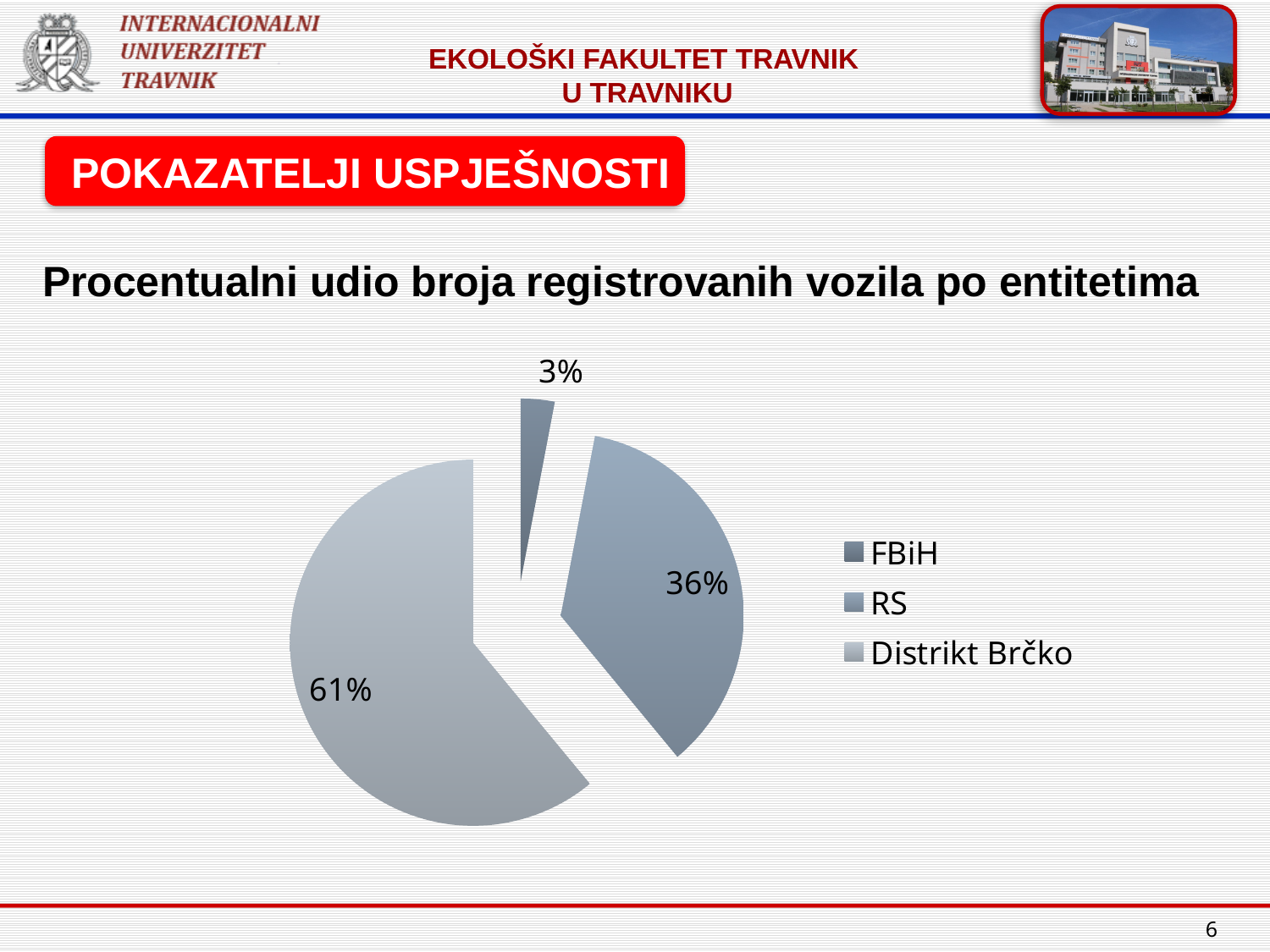
What kind of chart is shown on the slide? pie chart What is the difference between the largest slice (61%) and the 36% slice? 25% What share of the pie does the slice coloured like the Distrikt Brčko legend entry have? 61% Which is larger, the 36% slice or the 3% slice? the 36% slice How many slices does the pie chart have? 3 What share of the pie does the slice coloured like the FBiH legend entry have? 3% What is the title of the chart on the slide? Procentualni udio broja registrovanih vozila po entitetima What is the smallest percentage shown on the pie chart? 3% What is the largest percentage shown on the pie chart? 61% How many entries does the legend of the pie chart list? 3 What share of the pie does the slice coloured like the RS legend entry have? 36% What is the difference between the 36% slice and the 3% slice? 33%